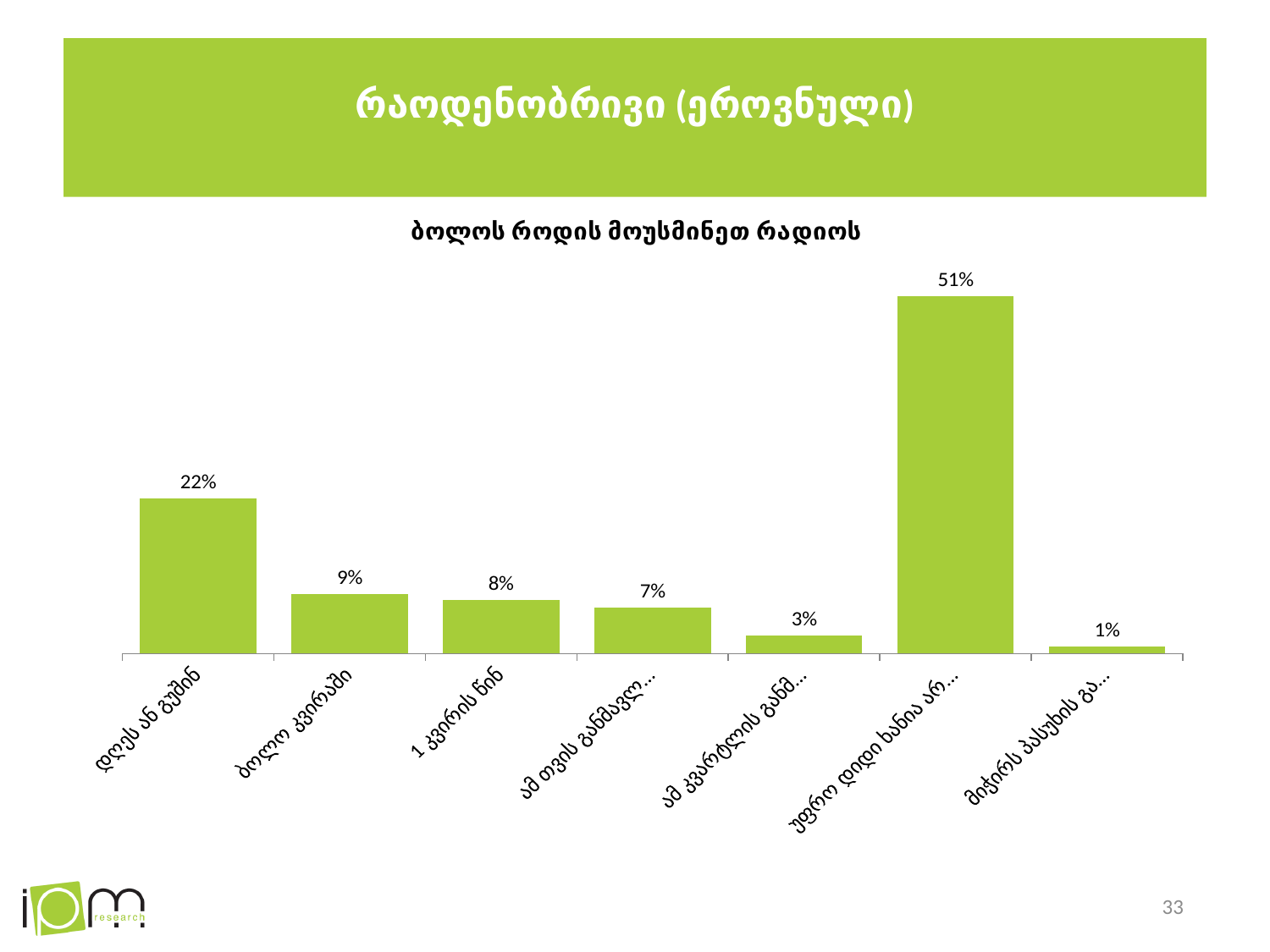
What is the title of the chart? ბოლოს როდის მოუსმინეთ რადიოს What is the difference between the highest bar (51%) and the bar for "დღეს ან გუშინ" (22%)? 29% Which category has the lowest value in the chart? მიჭირს პასუხის გა... What colour are the bars in the chart? Green What value is shown for the category "1 კვირის წინ"? 8% Which category has the highest value in the chart? უფრო დიდი ხანია არ... What is the difference between the values for "ბოლო კვირაში" and "1 კვირის წინ"? 1% What value is shown for the category "დღეს ან გუშინ"? 22% What value is shown for the category "ბოლო კვირაში"? 9% What type of chart is shown on the slide? Bar chart How many categories (bars) are shown in the chart? 7 Which is larger: the value for "ბოლო კვირაში" or the value for "1 კვირის წინ"? ბოლო კვირაში